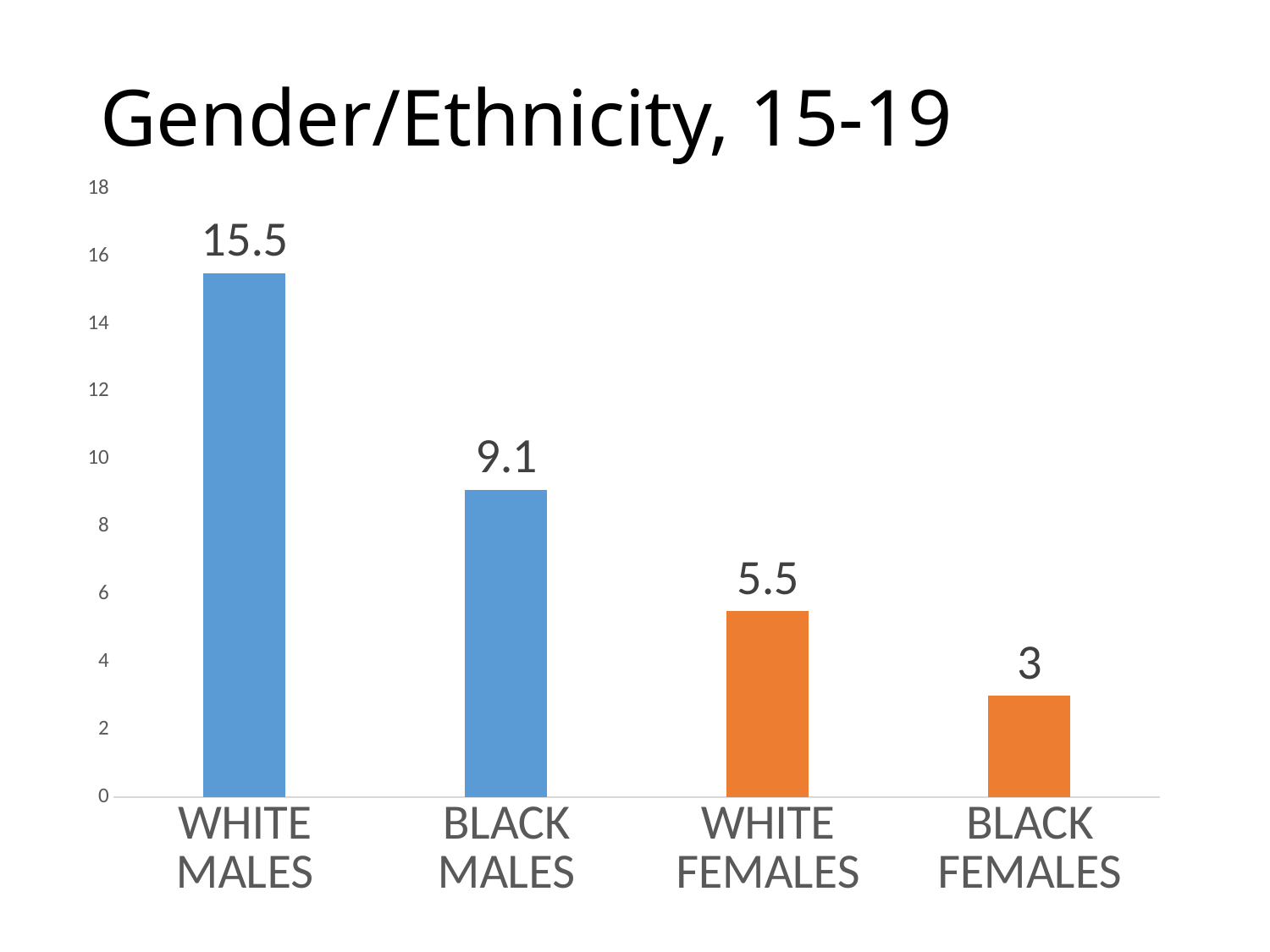
What is the difference between the values for White Females and Black Females? 2.5 How many categories are shown on the chart? 4 What is the title of the chart? Gender/Ethnicity, 15-19 Which category has the lowest value? Black Females What is the value for Black Males? 9.1 What kind of chart is shown on the slide? Bar chart What is the value for White Males? 15.5 What is the difference between the values for White Males and Black Males? 6.4 What is the value for White Females? 5.5 Which is larger, the value for Black Males or the value for White Females? Black Males What is the value for Black Females? 3 Which category has the highest value? White Males